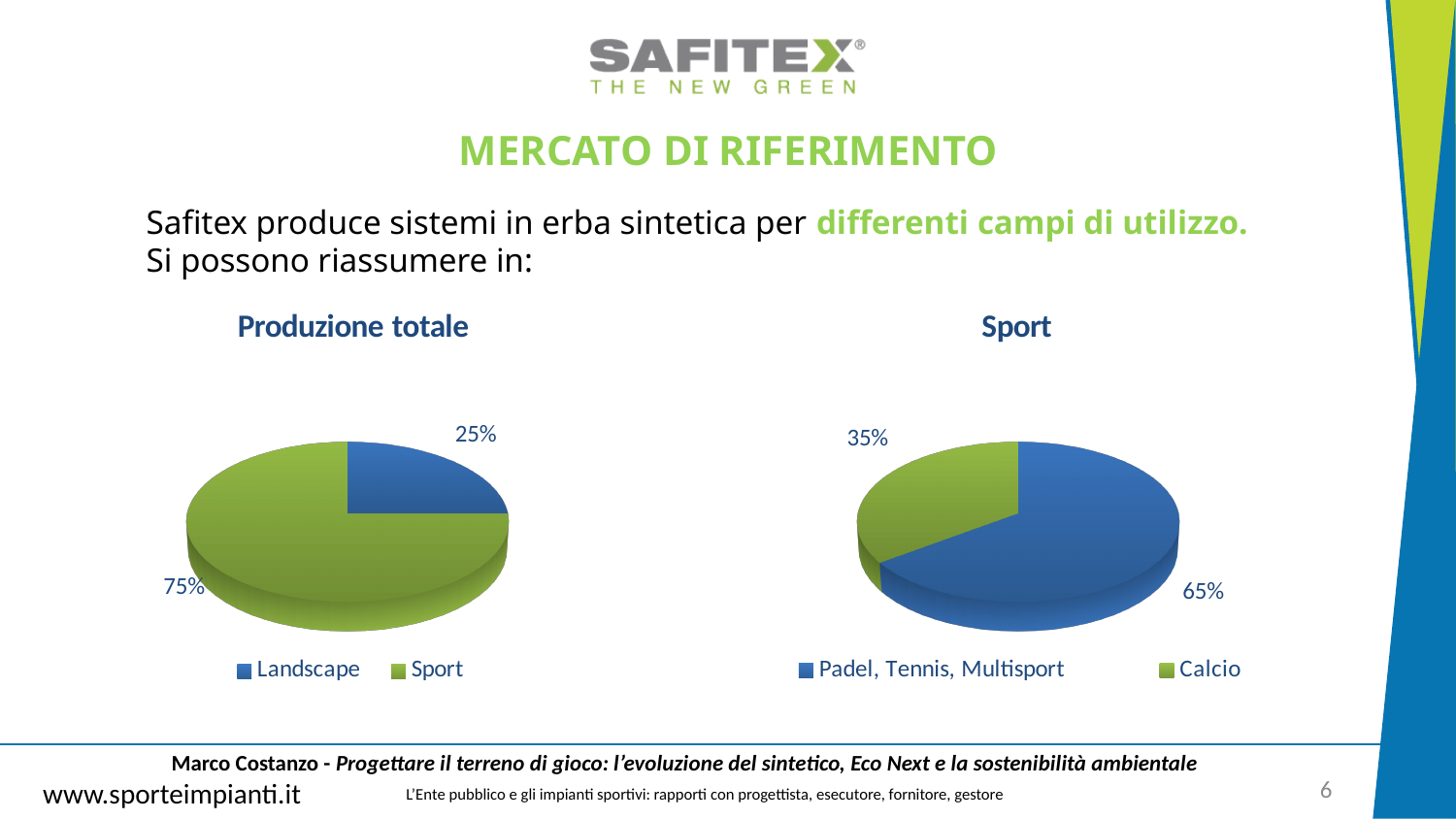
In the 'Sport' chart, which category has the smallest slice? Calcio In the 'Produzione totale' chart, what is the difference between the Sport and Landscape shares? 50% In the 'Sport' chart, what share does Calcio have? 35% What type of chart is the 'Produzione totale' chart? Pie chart In the 'Produzione totale' chart, what colour is the Landscape slice? Blue In the 'Produzione totale' chart, what share does Landscape have? 25% In the 'Sport' chart, what share does 'Padel, Tennis, Multisport' have? 65% How many categories does the 'Sport' chart's legend list? 2 In the 'Produzione totale' chart, which category has the largest slice? Sport In the 'Sport' chart, which is larger: Calcio or 'Padel, Tennis, Multisport'? Padel, Tennis, Multisport In the 'Sport' chart, what is the difference between the 'Padel, Tennis, Multisport' share and the Calcio share? 30% In the 'Produzione totale' chart, what share does Sport have? 75%